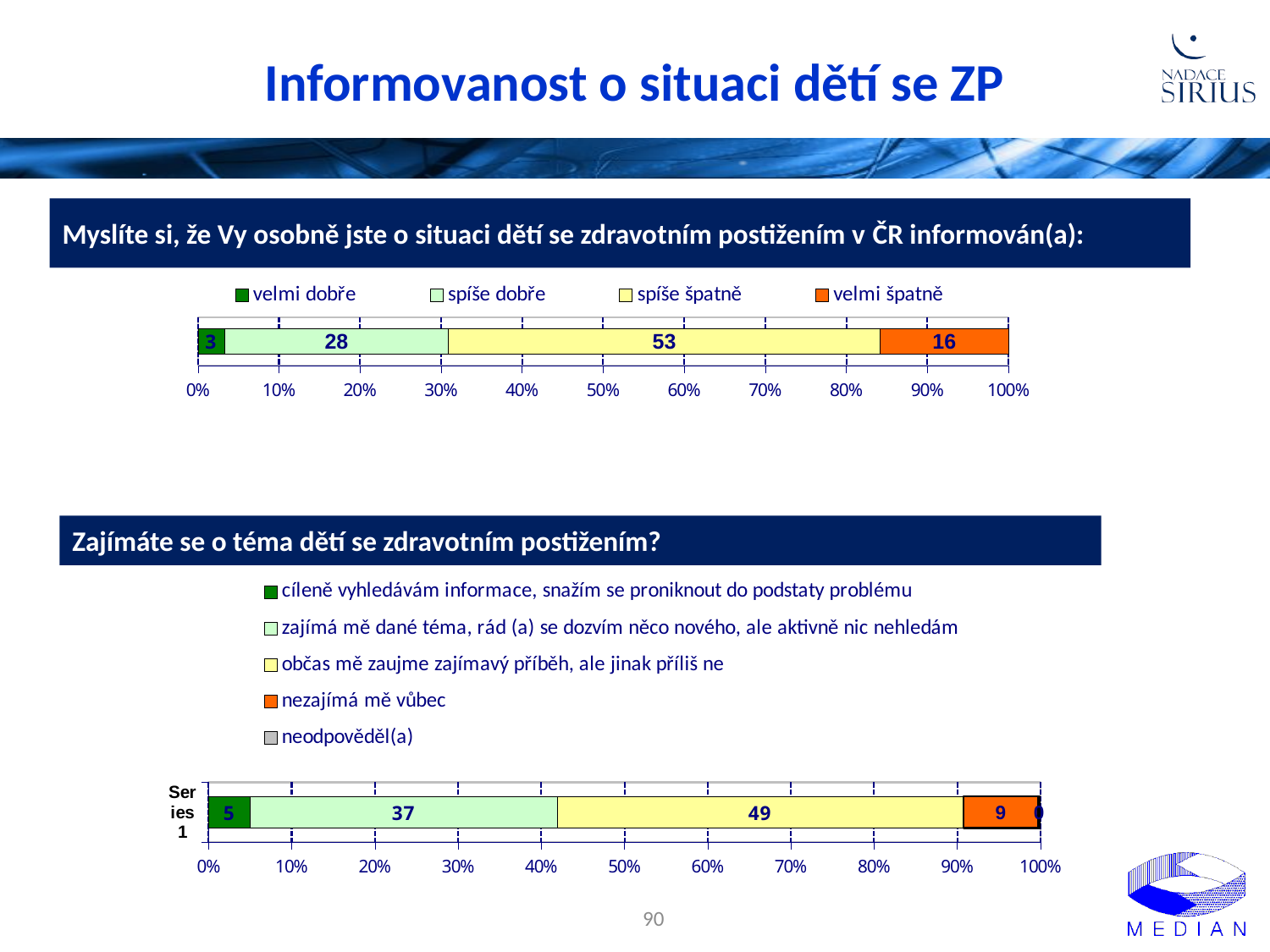
In the chart 'Zajímáte se o téma dětí se zdravotním postižením?', what is the value for 'zajímá mě dané téma, rád (a) se dozvím něco nového, ale aktivně nic nehledám'? 37 In the chart 'Zajímáte se o téma dětí se zdravotním postižením?', which is larger: 'cíleně vyhledávám informace, snažím se proniknout do podstaty problému' or 'nezajímá mě vůbec'? nezajímá mě vůbec What kind of chart is the chart 'Zajímáte se o téma dětí se zdravotním postižením?'? stacked bar chart In the chart 'Myslíte si, že Vy osobně jste o situaci dětí se zdravotním postižením v ČR informován(a):', which category has the lowest value? velmi dobře How many series does the legend list in the chart 'Myslíte si, že Vy osobně jste o situaci dětí se zdravotním postižením v ČR informován(a):'? 4 In the chart 'Zajímáte se o téma dětí se zdravotním postižením?', what is the value for 'nezajímá mě vůbec'? 9 In the chart 'Myslíte si, že Vy osobně jste o situaci dětí se zdravotním postižením v ČR informován(a):', what is the value for 'spíše špatně'? 53 In the chart 'Myslíte si, že Vy osobně jste o situaci dětí se zdravotním postižením v ČR informován(a):', what is the difference between 'spíše dobře' and 'velmi špatně'? 12 How many series does the legend list in the chart 'Zajímáte se o téma dětí se zdravotním postižením?'? 5 In the chart 'Myslíte si, že Vy osobně jste o situaci dětí se zdravotním postižením v ČR informován(a):', which category has the highest value? spíše špatně In the chart 'Zajímáte se o téma dětí se zdravotním postižením?', which category has the highest value? občas mě zaujme zajímavý příběh, ale jinak příliš ne In the chart 'Myslíte si, že Vy osobně jste o situaci dětí se zdravotním postižením v ČR informován(a):', what is the value for 'velmi dobře'? 3